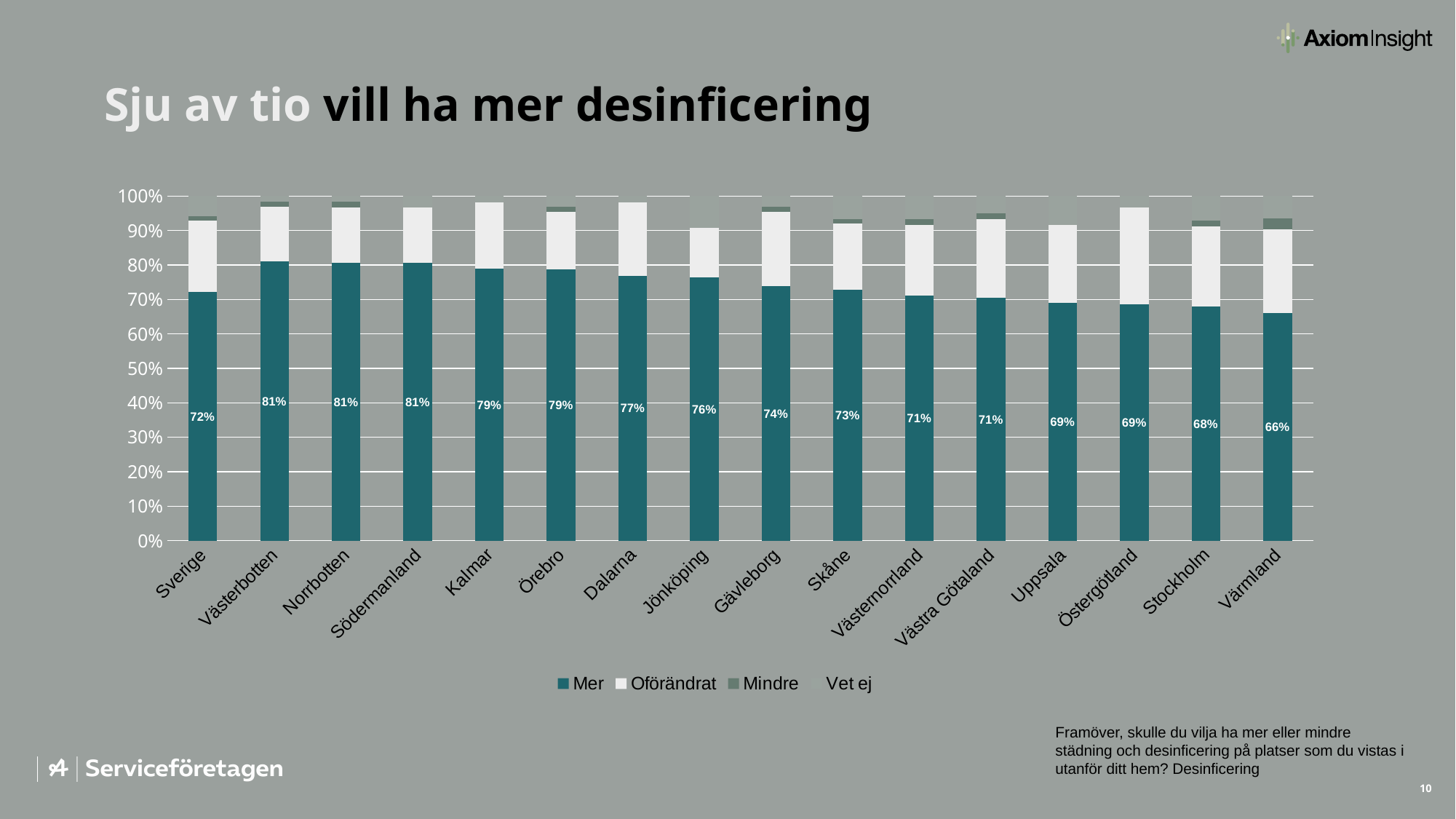
What percentage of respondents in Sverige answered "Mer"? 72% Which region has the lowest "Mer" value? Värmland What is the difference between the "Mer" values for Västerbotten and Värmland? 15 percentage points What is the "Mer" value for Stockholm? 68% What is the difference between the "Mer" values for Kalmar and Skåne? 6 percentage points How many regions (categories) are shown on the x axis? 16 How many series does the legend list? 4 Which has a larger "Mer" value, Dalarna or Uppsala? Dalarna Which series is shown in dark teal in the legend? Mer What kind of chart is shown on the slide? Stacked bar chart What is the "Mer" value for Jönköping? 76% Which has a larger "Mer" value, Gävleborg or Östergötland? Gävleborg